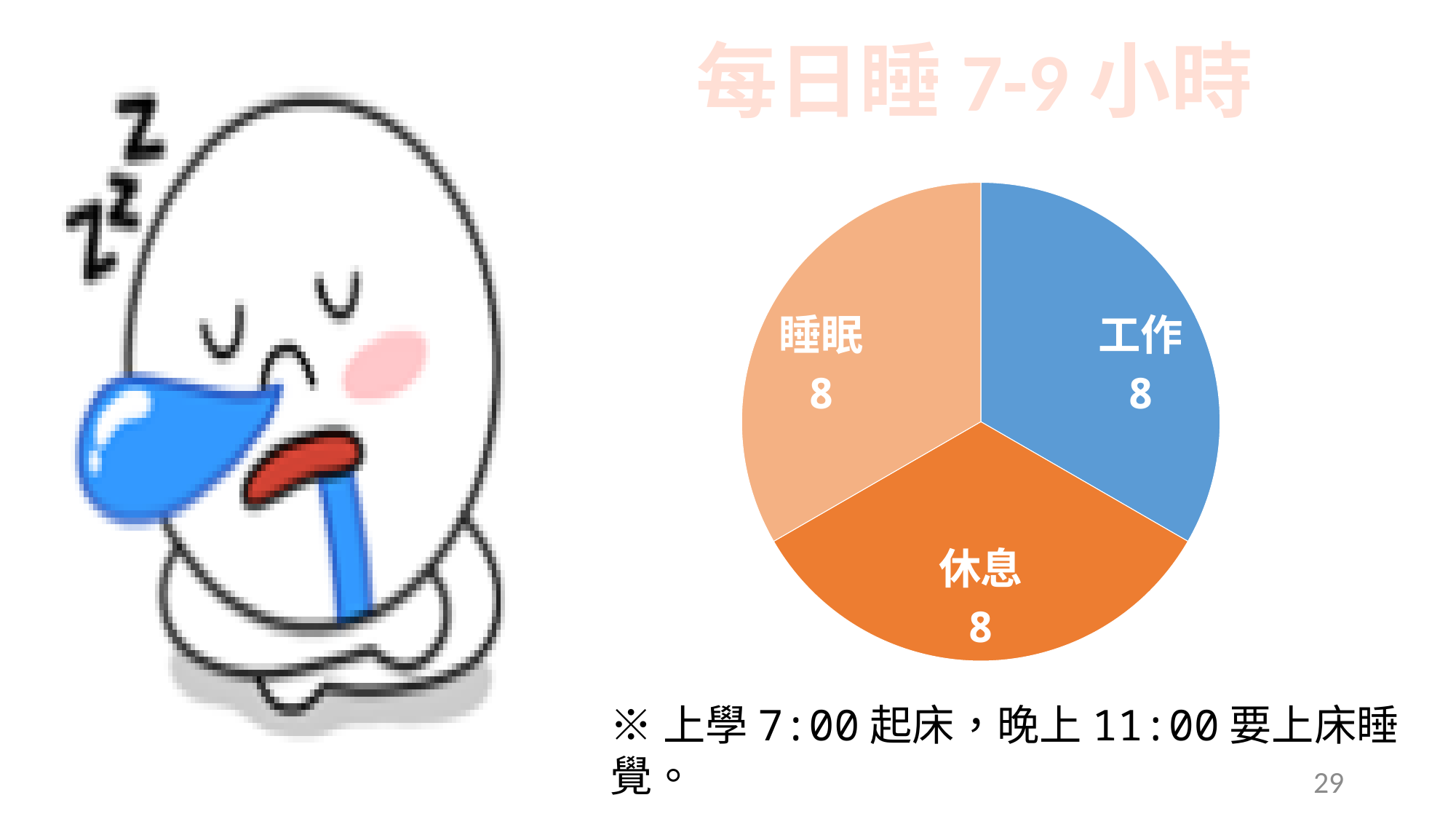
What is the value shown for 工作 in the pie chart? 8 Are the three slices of the pie chart equal in value? yes What share of the pie does the 睡眠 slice represent? one third What kind of chart is shown on the slide? pie chart Which slice of the pie chart is coloured dark orange? 休息 What is the difference between the values for 工作 and 睡眠 in the pie chart? 0 How many slices does the pie chart have? 3 What is the value shown for 睡眠 in the pie chart? 8 What colour is the 工作 slice in the pie chart? blue What is the total of all the slice values in the pie chart? 24 What is the value shown for 休息 in the pie chart? 8